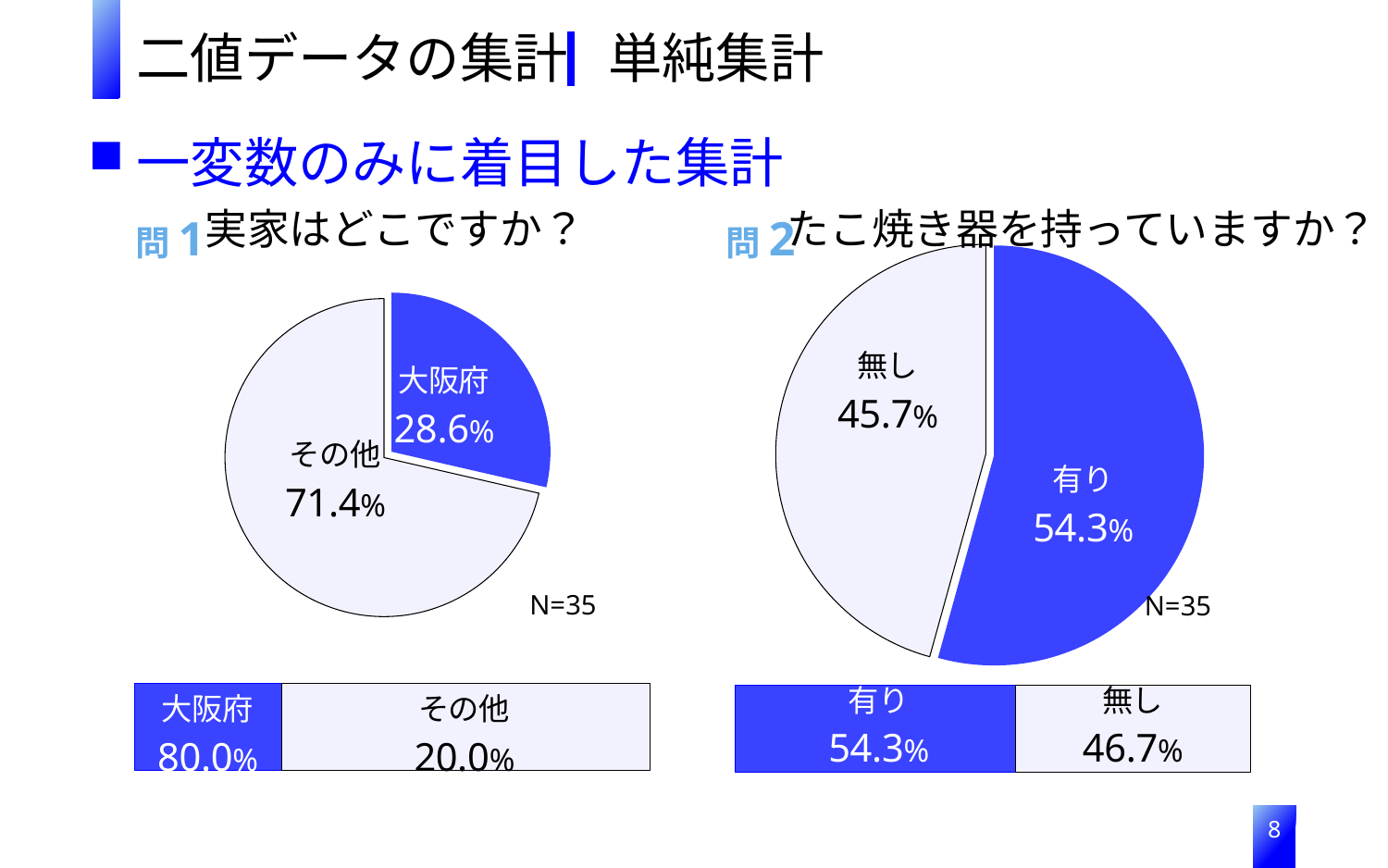
What sample size (N) is shown next to the pie chart for 問2 たこ焼き器を持っていますか？? N=35 In the pie chart for 問2 たこ焼き器を持っていますか？, what is the share for 有り? 54.3% In the pie chart for 問2 たこ焼き器を持っていますか？, which category has the smallest slice? 無し In the pie chart for 問2 たこ焼き器を持っていますか？, what is the share for 無し? 45.7% What kind of chart is used for 問1 実家はどこですか？ at the top left of the slide? Pie chart In the horizontal bar at the bottom left of the slide, what value is shown for 大阪府? 80.0% In the pie chart for 問1 実家はどこですか？, what is the share for 大阪府? 28.6% How many categories does the pie chart for 問2 たこ焼き器を持っていますか？ show? 2 In the pie chart for 問2 たこ焼き器を持っていますか？, which is larger, 有り or 無し? 有り In the pie chart for 問1 実家はどこですか？, which category has the largest slice? その他 In the pie chart for 問1 実家はどこですか？, what is the difference between the shares of その他 and 大阪府? 42.8% In the pie chart for 問1 実家はどこですか？, what is the share for その他? 71.4%